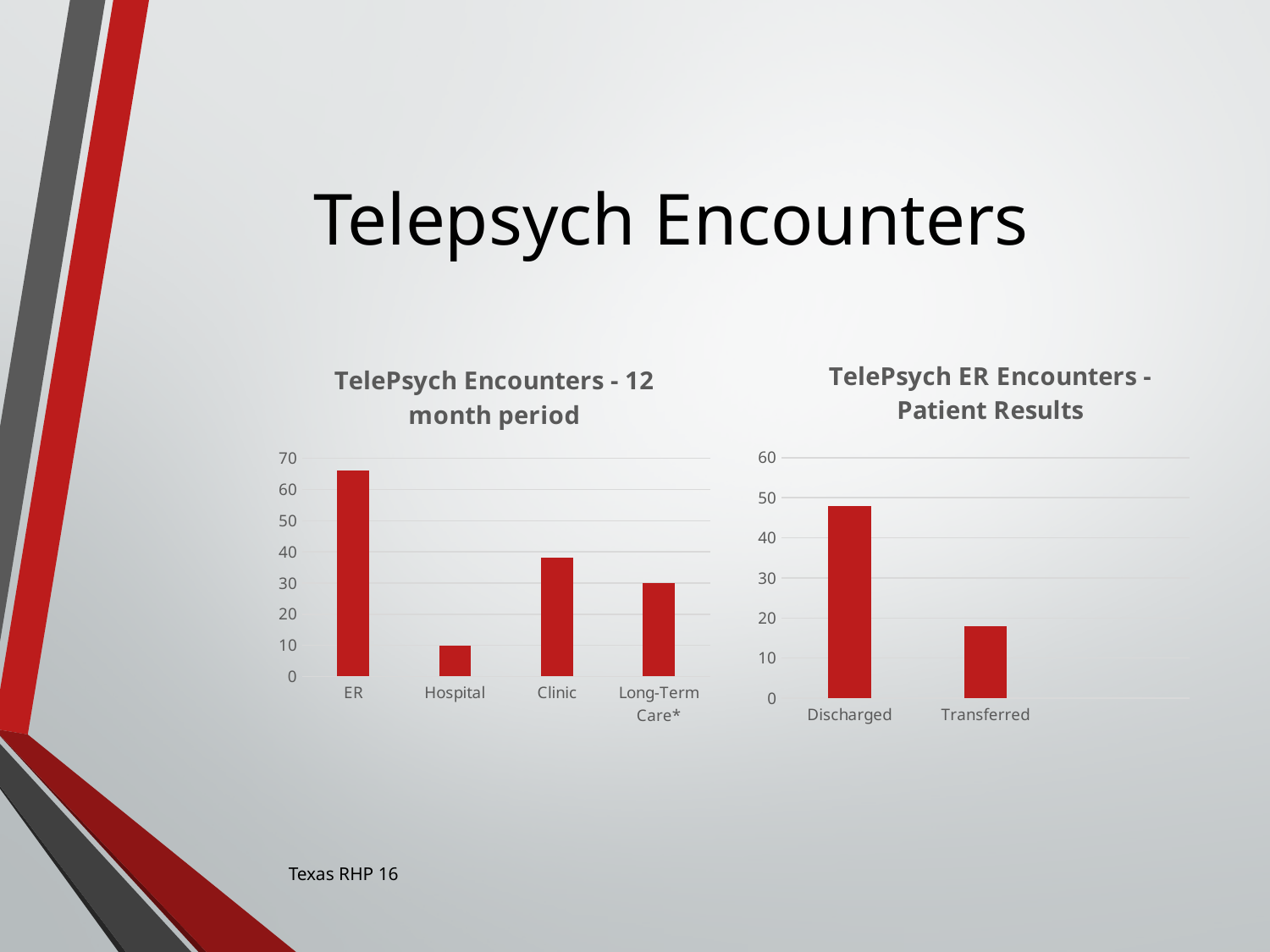
In the 'TelePsych Encounters - 12 month period' chart, is the value for ER greater or less than 60? greater In the 'TelePsych Encounters - 12 month period' chart, which category has the highest value? ER In the 'TelePsych ER Encounters - Patient Results' chart, is the value for Transferred greater or less than 20? less In the 'TelePsych ER Encounters - Patient Results' chart, is the value for Discharged greater or less than 40? greater What kind of chart is the 'TelePsych Encounters - 12 month period' chart? Bar chart What is the title of the chart on the right side of the slide? TelePsych ER Encounters - Patient Results In the 'TelePsych Encounters - 12 month period' chart, how many categories are shown on the x axis? 4 In the 'TelePsych ER Encounters - Patient Results' chart, how many categories are shown? 2 In the 'TelePsych Encounters - 12 month period' chart, which is larger, the value for Clinic or the value for Long-Term Care*? Clinic In the 'TelePsych ER Encounters - Patient Results' chart, which category has the highest value? Discharged In the 'TelePsych Encounters - 12 month period' chart, which category has the lowest value? Hospital